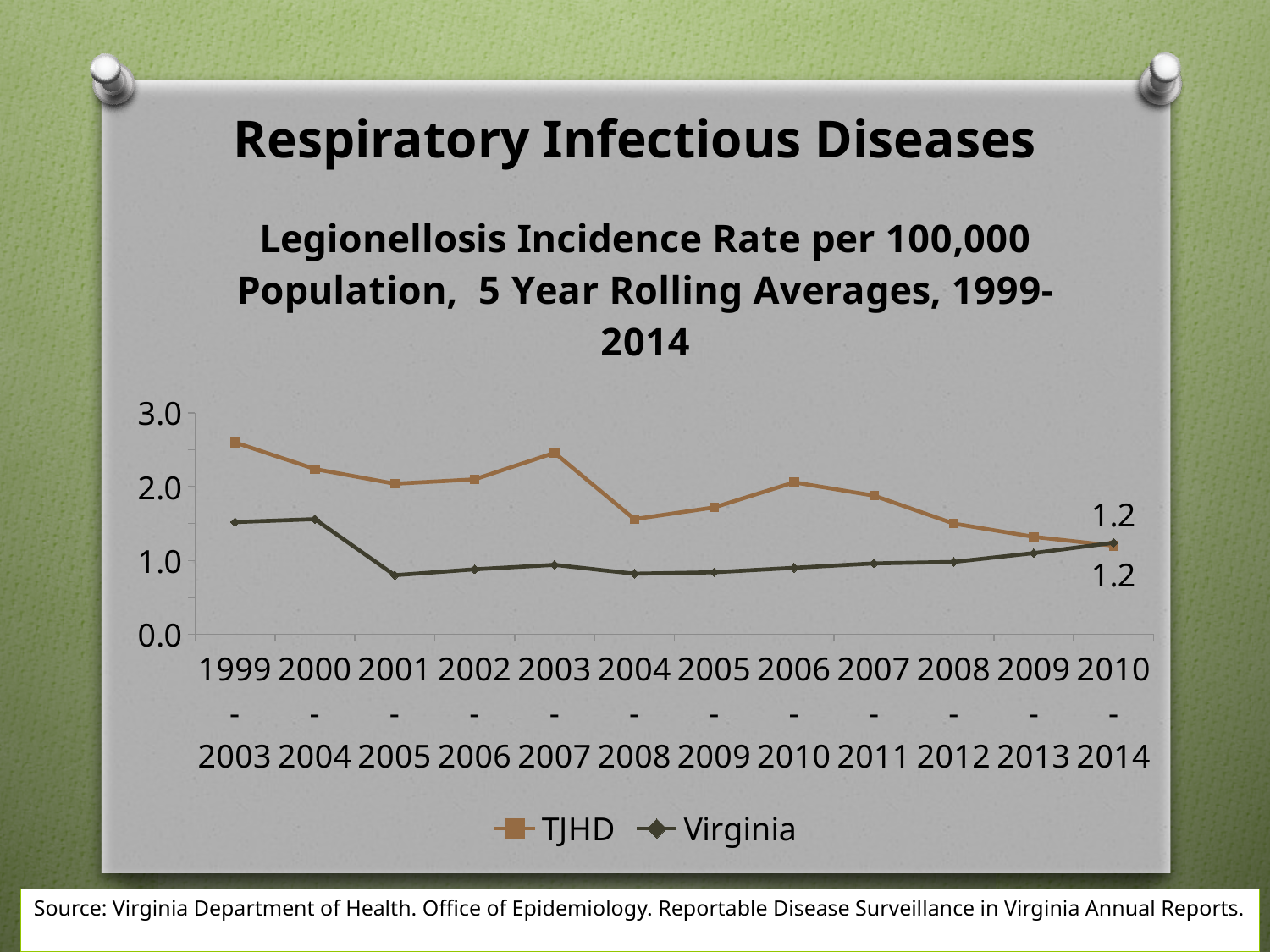
Does the TJHD line generally rise or fall from 1999-2003 to 2010-2014? Fall In which period is the TJHD value highest? 1999-2003 Which series is drawn with square markers? TJHD What is the Virginia value for 2010-2014? 1.2 Which series has the larger value in 1999-2003, TJHD or Virginia? TJHD Is the Virginia value for 2001-2005 greater or less than 1.0? less How many time periods are shown along the x axis? 12 How many series does the legend list? 2 Is the TJHD value for 2004-2008 greater or less than 2.0? less What is the TJHD value for 2010-2014? 1.2 What kind of chart is shown on the slide? Line chart Is the TJHD value for 1999-2003 greater or less than 2.0? greater